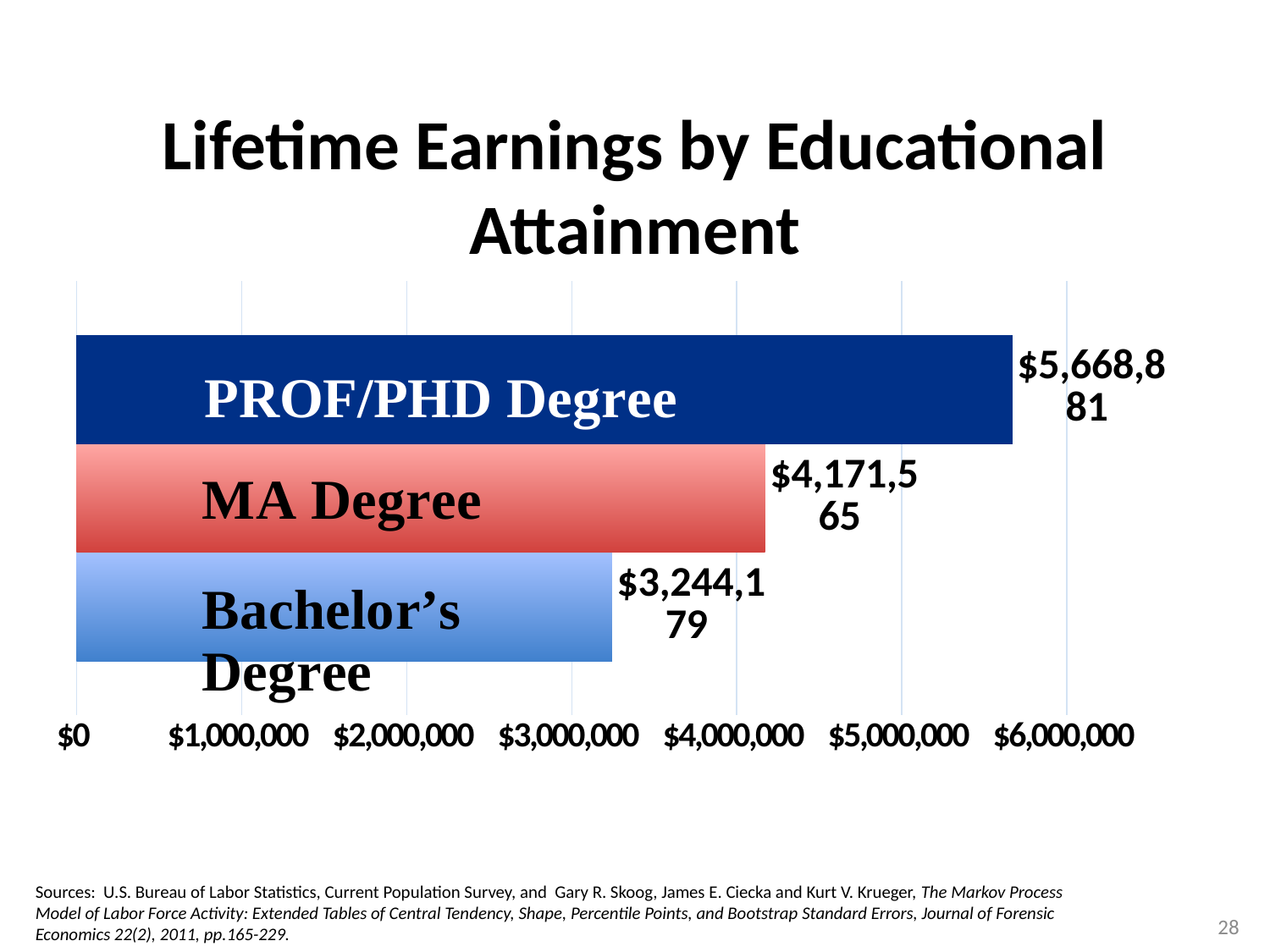
What is the difference in lifetime earnings between the MA Degree and the Bachelor's Degree? $927,386 Is the value for the MA Degree greater or less than $4,000,000? greater What is the title of the chart on the slide? Lifetime Earnings by Educational Attainment What is the lifetime earnings value shown for the MA Degree bar? $4,171,565 What is the difference in lifetime earnings between the PROF/PHD Degree and the MA Degree? $1,497,316 Which has higher lifetime earnings, the MA Degree or the Bachelor's Degree? MA Degree How many educational attainment categories are plotted in the chart? 3 What is the lifetime earnings value shown for the PROF/PHD Degree bar? $5,668,881 What kind of chart is shown on the slide? Bar chart Which educational attainment category has the lowest lifetime earnings? Bachelor's Degree What is the lifetime earnings value shown for the Bachelor's Degree bar? $3,244,179 Which educational attainment category has the highest lifetime earnings? PROF/PHD Degree